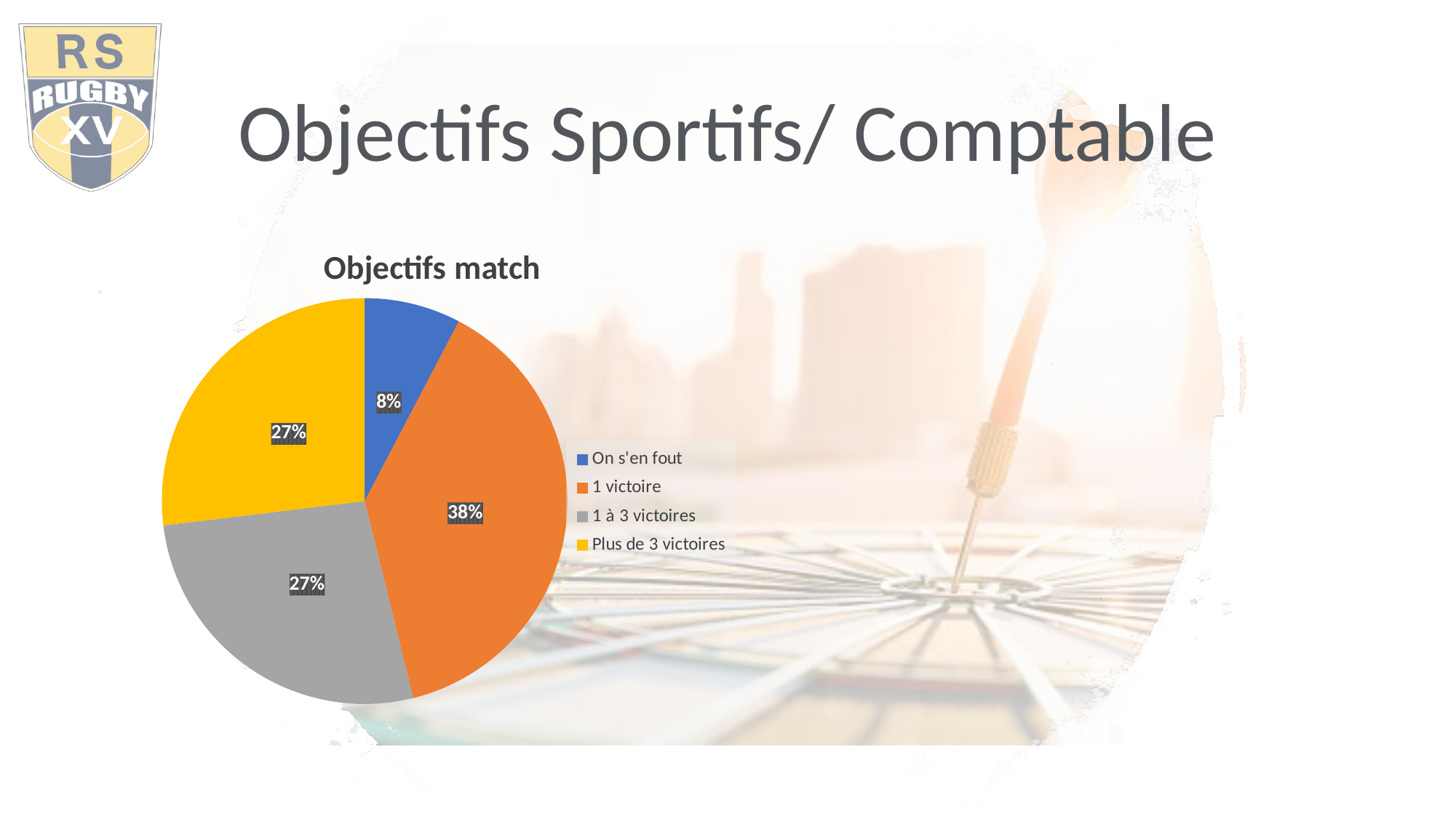
How many categories does the pie chart have? 4 Which category has the smallest slice of the pie? On s'en fout Which category has the largest slice of the pie? 1 victoire What is the title of the chart? Objectifs match Which is larger, the slice for '1 victoire' or the slice for '1 à 3 victoires'? 1 victoire What is the difference in percentage points between '1 victoire' and 'On s'en fout'? 30 What colour is the slice for 'Plus de 3 victoires'? yellow What share of the pie does 'On s'en fout' take? 8% What share of the pie does 'Plus de 3 victoires' take? 27% What share of the pie does '1 victoire' take? 38% What kind of chart is shown on the slide? pie chart